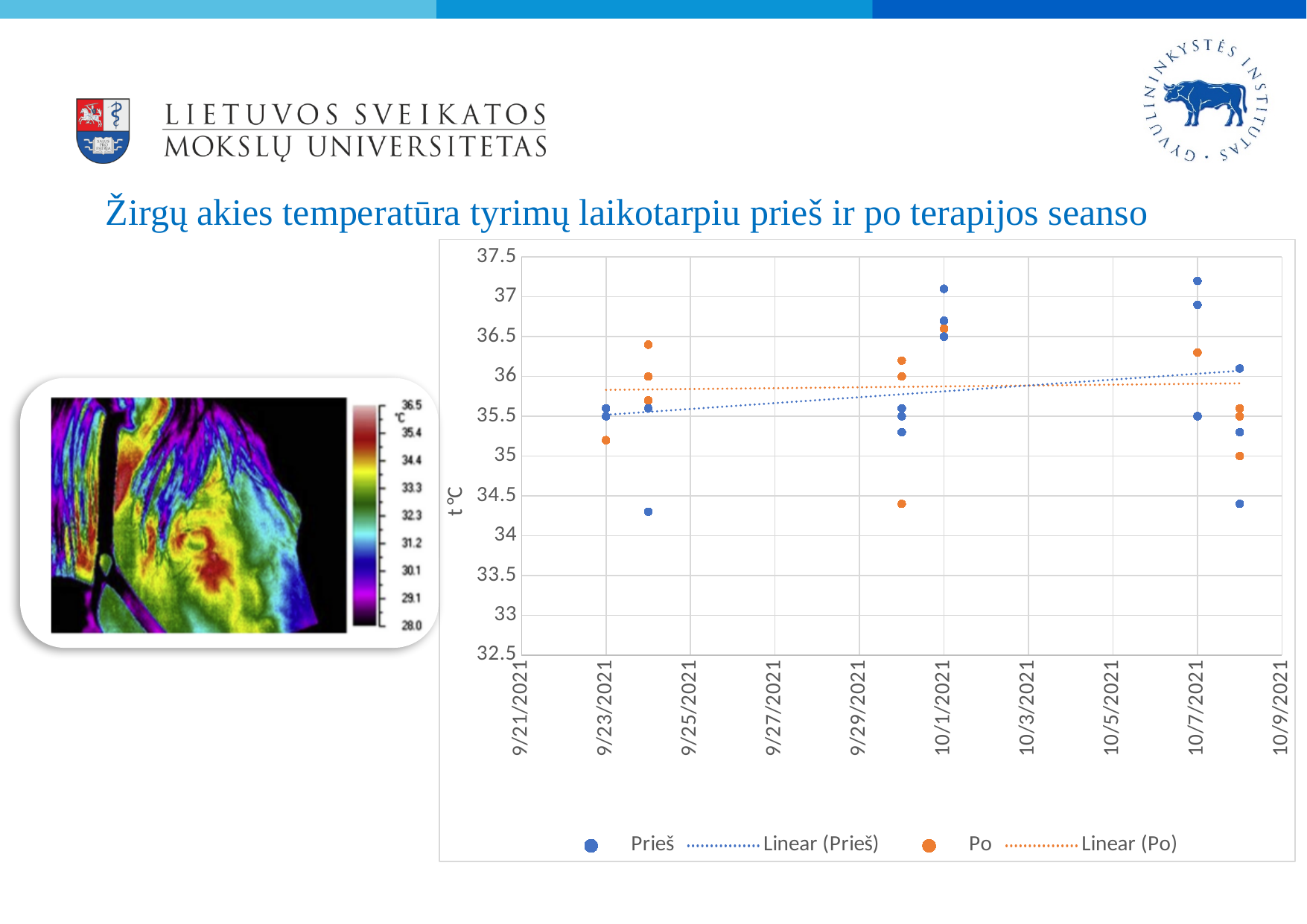
Is the highest 'Prieš' value in the chart greater or less than 37? greater What colour are the 'Po' data points in the chart? Orange What is the lowest value shown on the y axis of the chart? 32.5 How many entries does the chart legend list? 4 What kind of chart is shown on the slide? Scatter chart Is the lowest 'Prieš' value in the chart greater or less than 34.5? less What is the title of the y axis of the chart? t °C At the right end of the chart, which trendline is higher, 'Linear (Prieš)' or 'Linear (Po)'? Linear (Prieš) Does the 'Linear (Prieš)' trendline rise or fall from left to right along the x axis? Rises What is the highest value shown on the y axis of the chart? 37.5 Is the lowest 'Po' value in the chart greater or less than 35? less How many date labels are shown on the x axis of the chart? 10